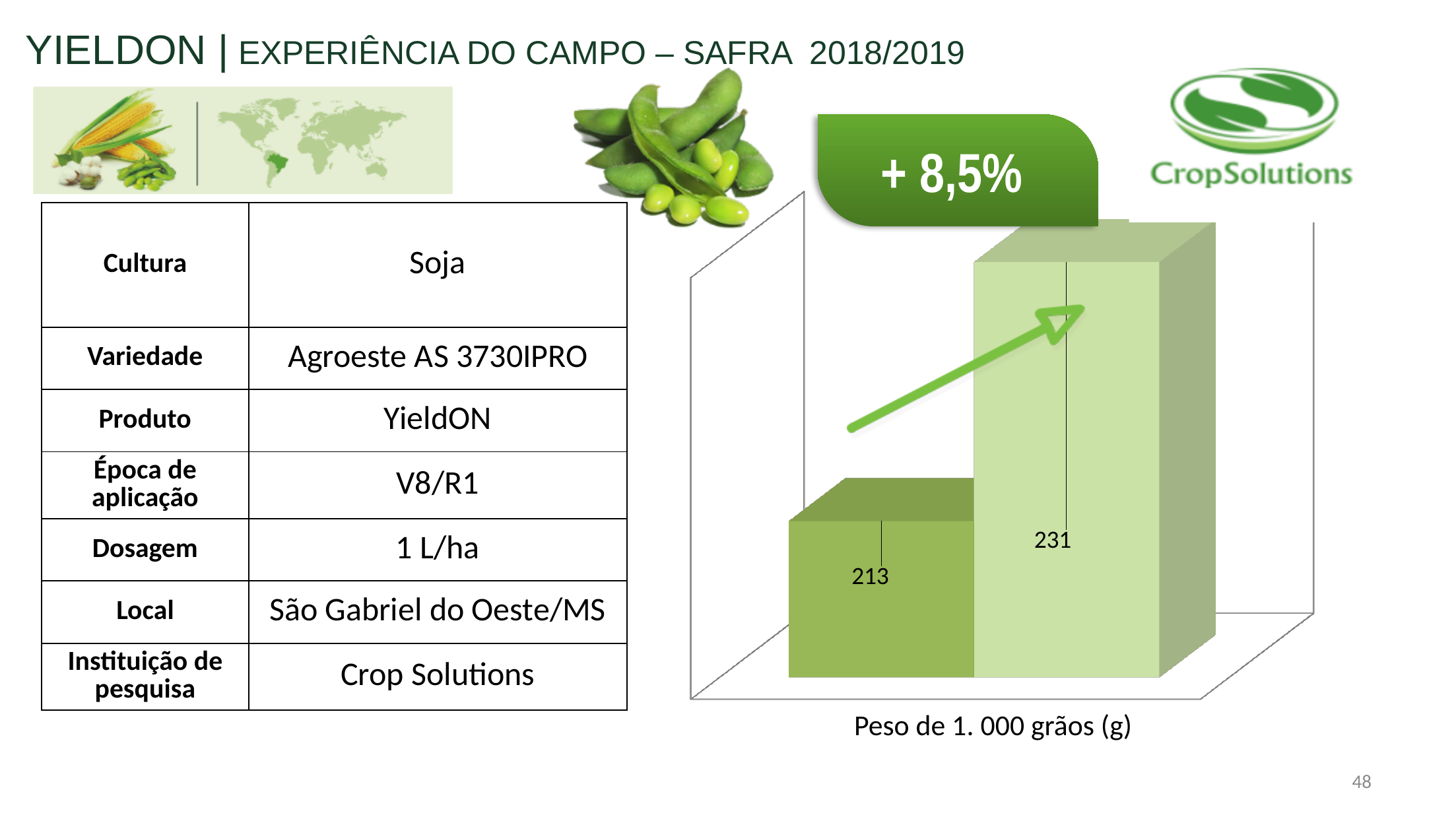
Which bar has the highest value, the left or the right one? the right bar What type of chart is shown on the slide? bar chart Is the value of the right bar larger or smaller than the value of the left bar? larger How many bars are plotted in the chart? 2 What is the value shown on the right (lighter green) bar? 231 What is the title shown below the chart? Peso de 1. 000 grãos (g) What percentage increase is shown in the callout above the chart? + 8,5% What is the difference between the two bar values in the chart? 18 Do the bar values rise or fall from left to right? rise Which bar has the lowest value, the left or the right one? the left bar What is the value shown on the left (darker green) bar? 213